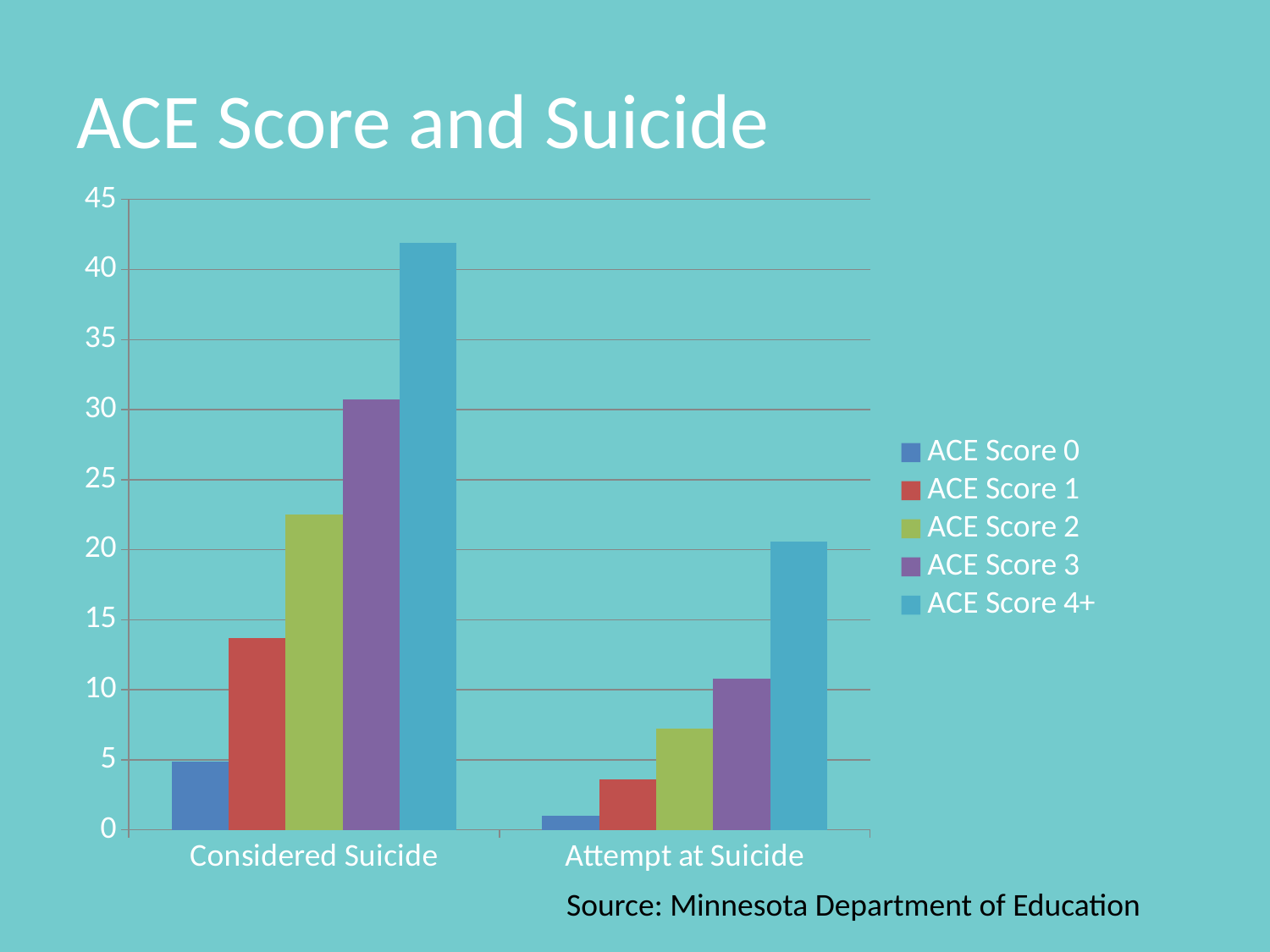
Is the value for ACE Score 3 under Considered Suicide greater or less than 35? less How many series does the legend list? 5 What source is cited below the chart? Minnesota Department of Education What is the title of the chart? ACE Score and Suicide Which series has the highest value for Considered Suicide? ACE Score 4+ How many categories are shown on the x axis? 2 Which series has the lowest value for Attempt at Suicide? ACE Score 0 Is the value for ACE Score 2 under Attempt at Suicide greater or less than 10? less Which is larger: ACE Score 1 for Considered Suicide or ACE Score 3 for Attempt at Suicide? ACE Score 1 for Considered Suicide What kind of chart is shown on the slide? bar chart Is the value for ACE Score 4+ under Considered Suicide greater or less than 40? greater